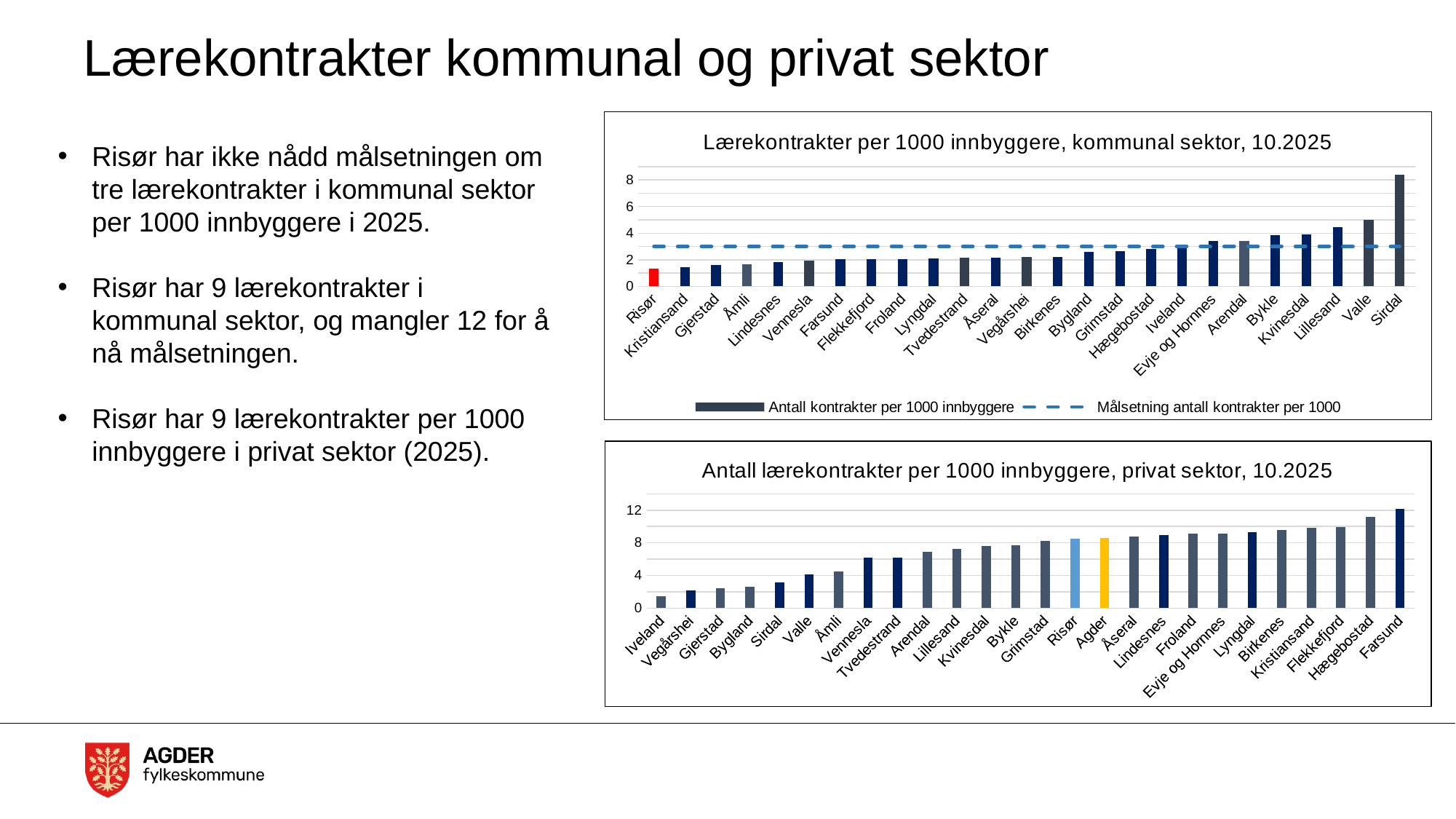
In the bottom chart (privat sektor), which municipality has the lowest value? Iveland In the top chart (kommunal sektor), is the value for Sirdal greater or less than 8? greater In the bottom chart (privat sektor), which municipality has the highest value? Farsund In the top chart (kommunal sektor), which municipality has the lowest number of contracts per 1000 inhabitants? Risør In the top chart (kommunal sektor), which has the larger value, Valle or Kristiansand? Valle In the bottom chart (privat sektor), is the value for Risør greater or less than 8? greater What kind of chart is the top chart, 'Lærekontrakter per 1000 innbyggere, kommunal sektor, 10.2025'? Combination bar and line chart (bars with a dashed target line) In the top chart (kommunal sektor), how many entries does the legend list? 2 In the top chart (kommunal sektor), what does the dashed line represent according to the legend? Målsetning antall kontrakter per 1000 In the top chart (kommunal sektor), which municipality has the highest number of contracts per 1000 inhabitants? Sirdal In the top chart (kommunal sektor), how many municipalities are plotted along the x axis? 25 In the top chart (kommunal sektor), is the value for Risør greater or less than 2? less